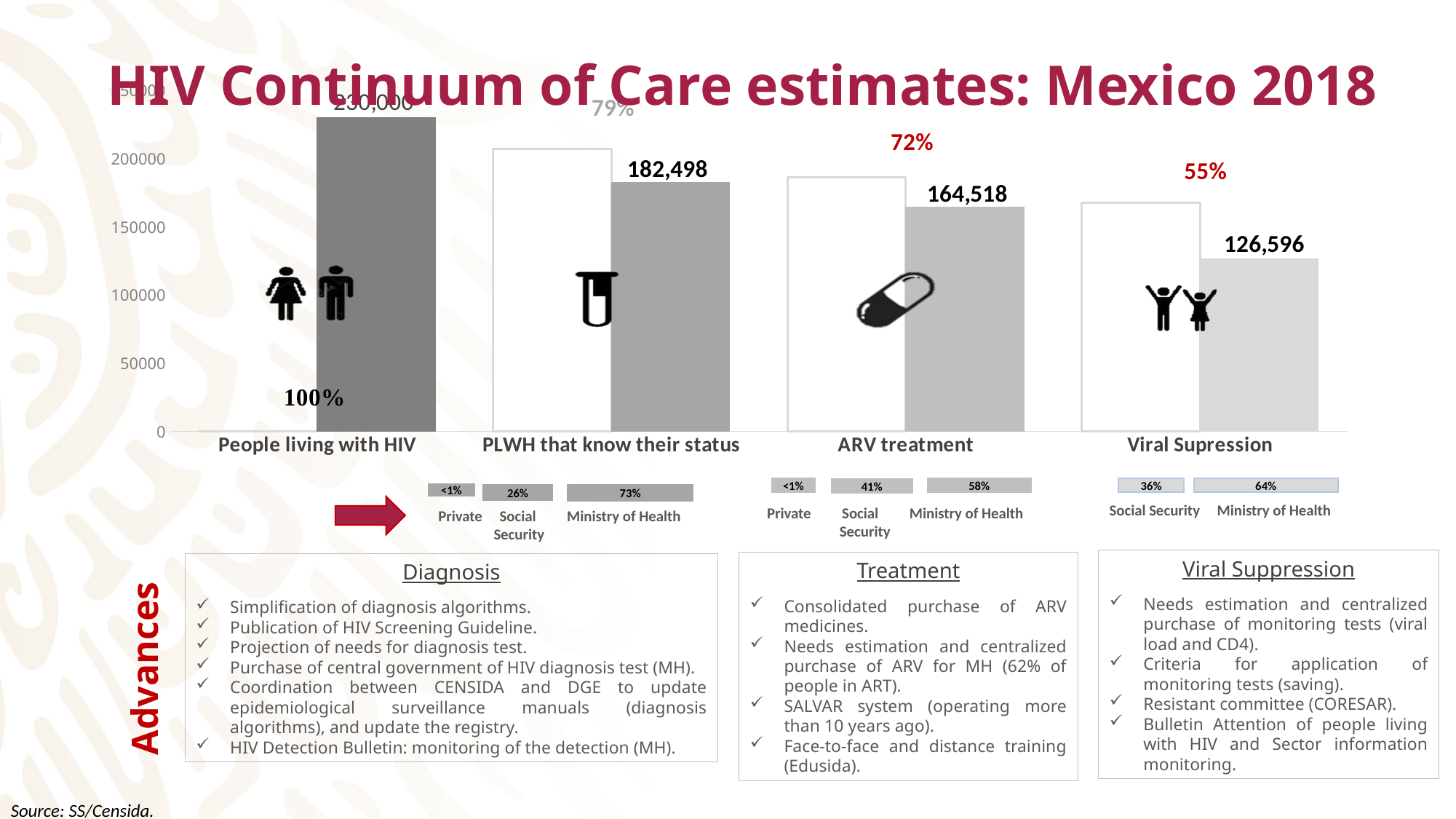
What is the value shown for ARV treatment? 164,518 Do the values rise or fall from left to right across the categories? Fall What is the difference between the values for ARV treatment and Viral Supression? 37,922 Which category has the lowest value in the chart? Viral Supression How many categories are shown on the x axis of the chart? 4 What is the value shown for Viral Supression? 126,596 Which is larger, the value for ARV treatment or the value for Viral Supression? ARV treatment What percentage is shown above the ARV treatment bar? 72% What kind of chart is shown on the slide? Bar chart What is the difference between the values for PLWH that know their status and ARV treatment? 17,980 What is the value shown for PLWH that know their status? 182,498 What percentage is shown above the Viral Supression bar? 55%